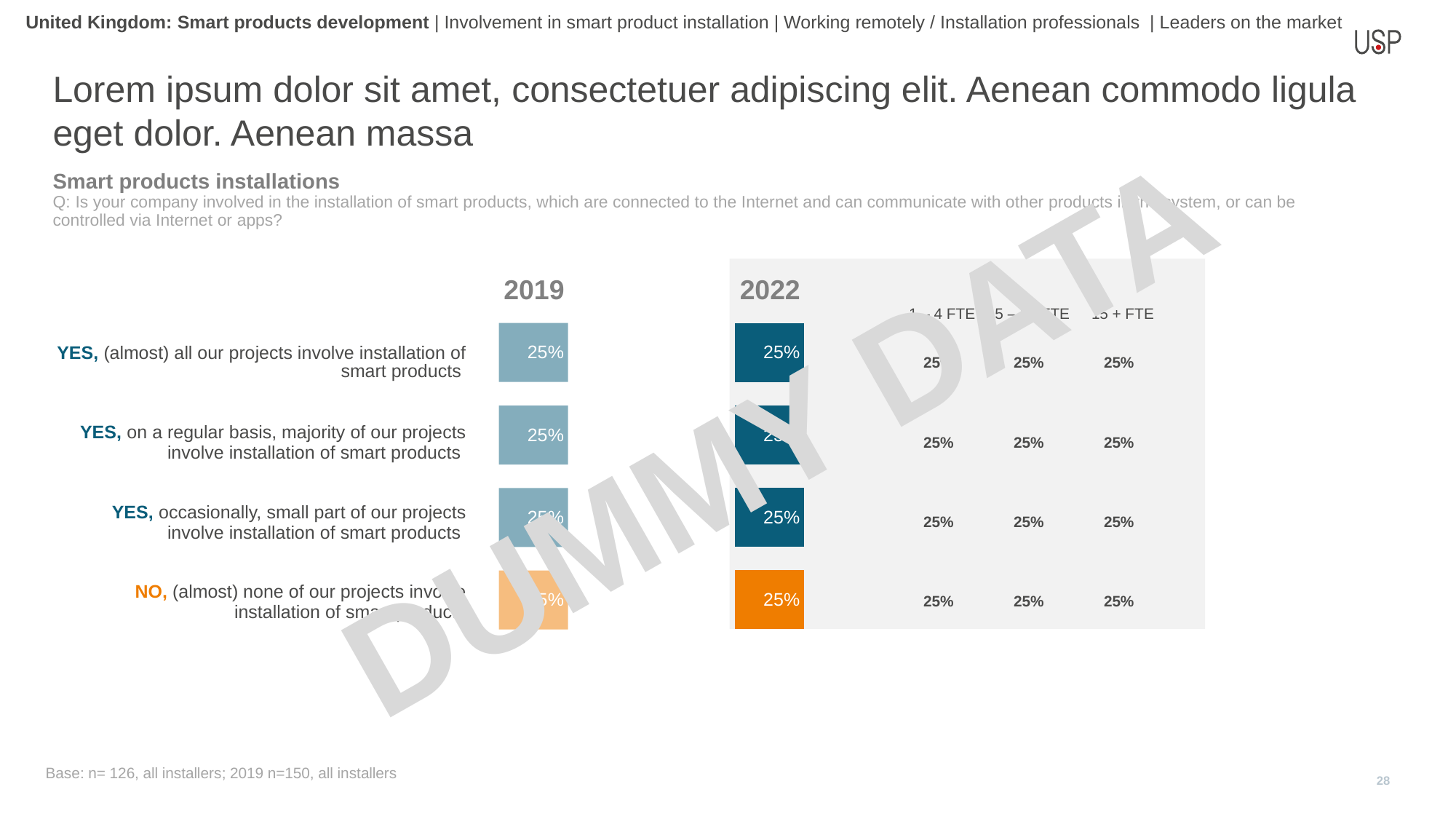
What kind of chart is used to show the 2022 results? Bar chart What is the title of the chart section on the slide? Smart products installations In the 2022 chart, what is the value for 'NO, (almost) none of our projects involve installation of smart products'? 25% Is the 2022 value for 'YES, occasionally, small part of our projects involve installation of smart products' larger than the 2019 value for 'YES, on a regular basis, majority of our projects involve installation of smart products'? No, they are equal (25%) How many categories are shown in the 2019 chart? 4 In the 2019 chart, what is the value for 'YES, on a regular basis, majority of our projects involve installation of smart products'? 25% In the 2019 chart, what is the value for 'YES, (almost) all our projects involve installation of smart products'? 25% What is the difference between the 2019 and 2022 values for 'YES, (almost) all our projects involve installation of smart products'? 0 percentage points In the 2022 chart, what is the value for 'YES, occasionally, small part of our projects involve installation of smart products'? 25% What colour is the 'NO, (almost) none of our projects involve installation of smart products' bar in the 2022 chart? Orange In the 2022 chart, what is the value for 'YES, (almost) all our projects involve installation of smart products'? 25% In the table to the right of the 2022 chart, what is the value for 'YES, (almost) all our projects involve installation of smart products' in the '15 + FTE' column? 25%